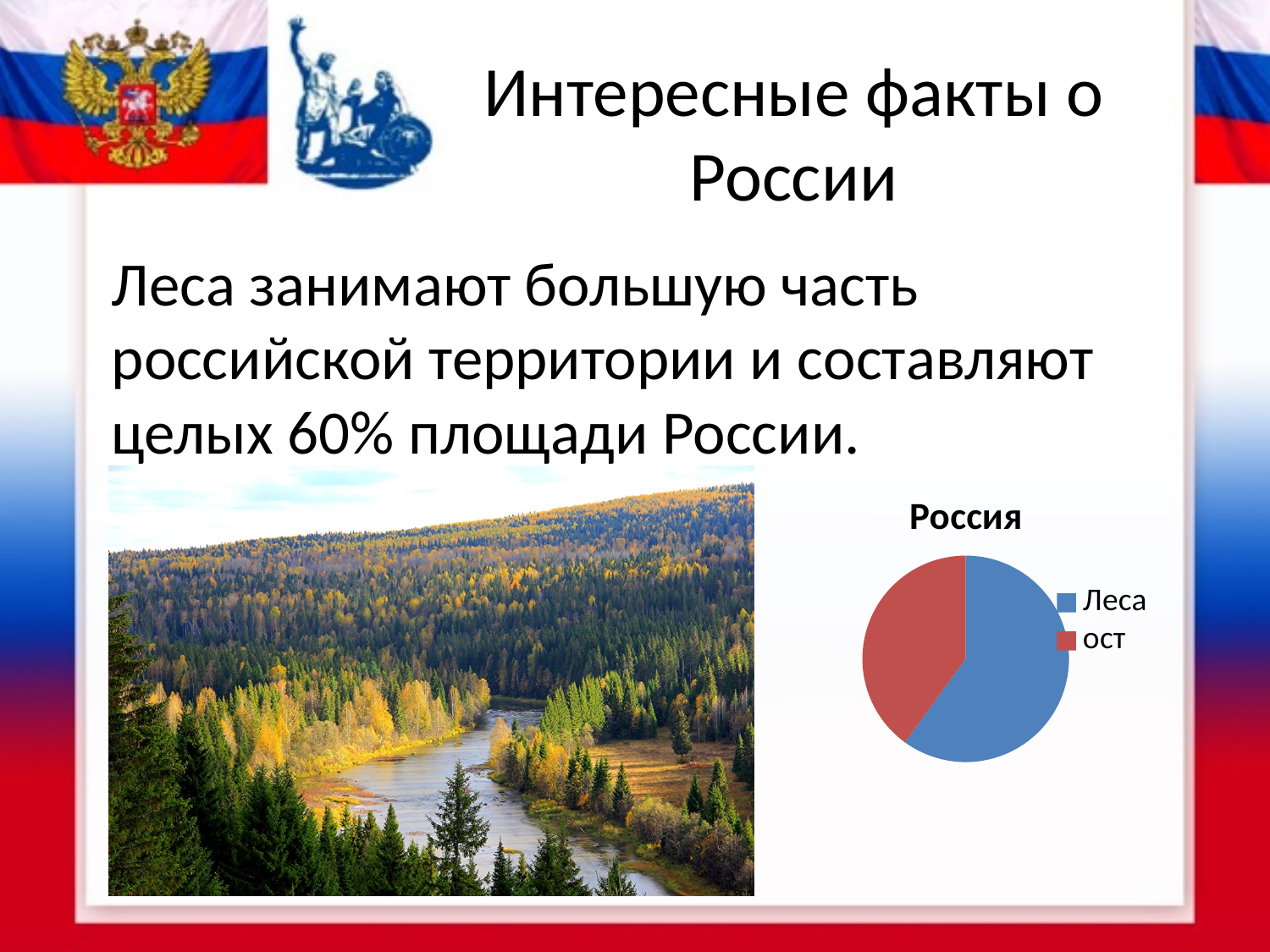
What is the title of the pie chart? Россия Which slice is larger in the pie chart, Леса or ост? Леса How many slices does the pie chart have? 2 What colour is the Леса slice in the pie chart? blue Which slice of the pie chart is the largest? Леса Which slice of the pie chart is the smallest? ост How many entries does the legend of the pie chart list? 2 What kind of chart is shown on the slide? pie chart